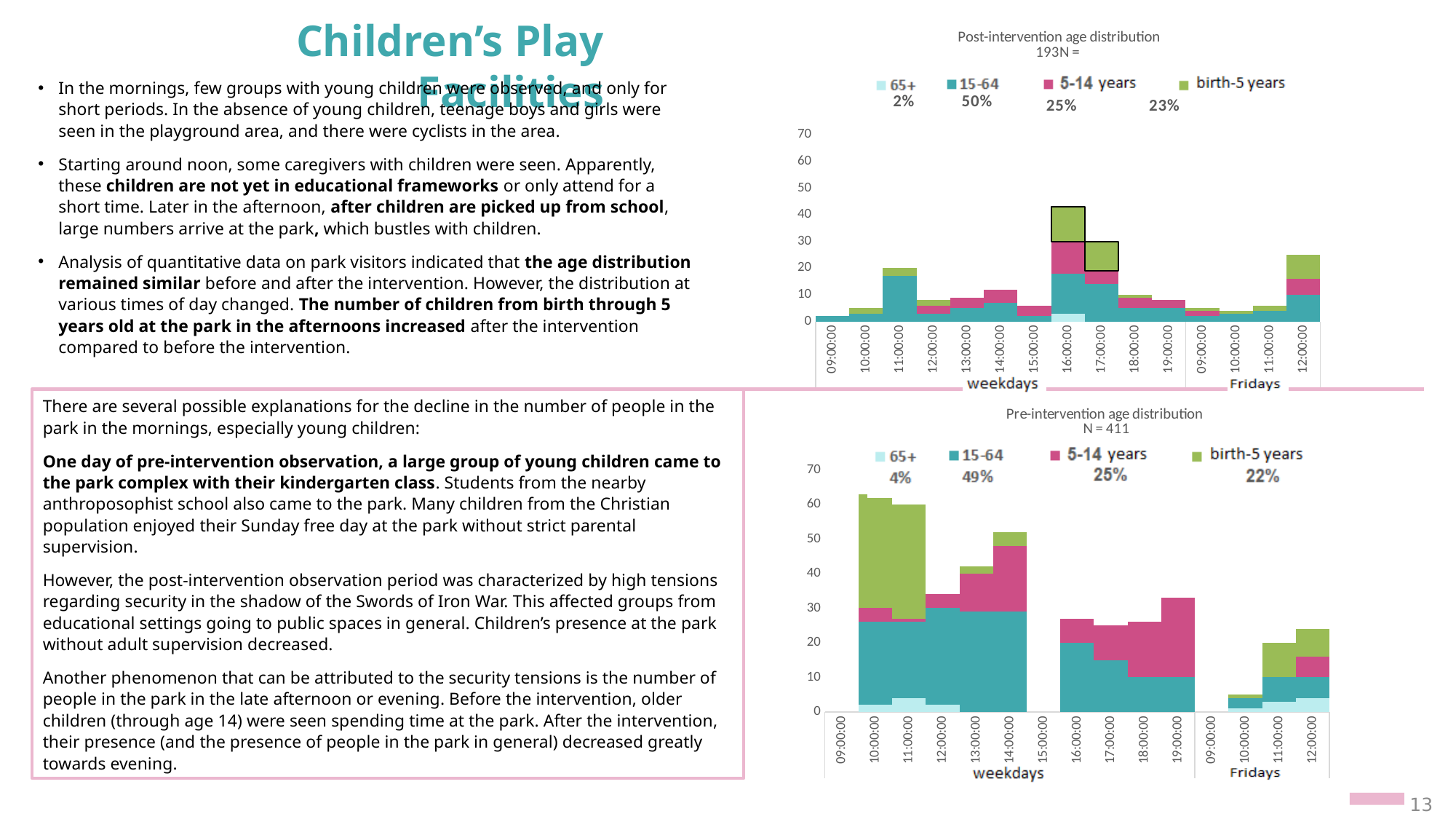
By how many percentage points does the 65+ share in the pre-intervention chart exceed the 65+ share in the post-intervention chart? 2 percentage points In the pre-intervention age distribution chart, is the total for 10:00:00 on weekdays greater or less than 50? greater In the post-intervention age distribution chart, what percentage of visitors were aged 15-64? 50% How many time-slot categories are shown on the x axis of the pre-intervention age distribution chart? 15 In the pre-intervention age distribution chart, what percentage of visitors were birth-5 years? 22% In the post-intervention age distribution chart, is the total for 16:00:00 on weekdays greater or less than 30? greater How many series does the legend of the pre-intervention age distribution chart list? 4 In the post-intervention age distribution chart, what is the sample size N? 193 What kind of chart is the post-intervention age distribution chart? Stacked bar chart In the pre-intervention age distribution chart, what percentage of visitors were aged 65+? 4% In the post-intervention age distribution chart, which time slot has the tallest bar? 16:00:00 weekdays In the post-intervention age distribution chart, is the total for 09:00:00 on weekdays greater or less than 10? less